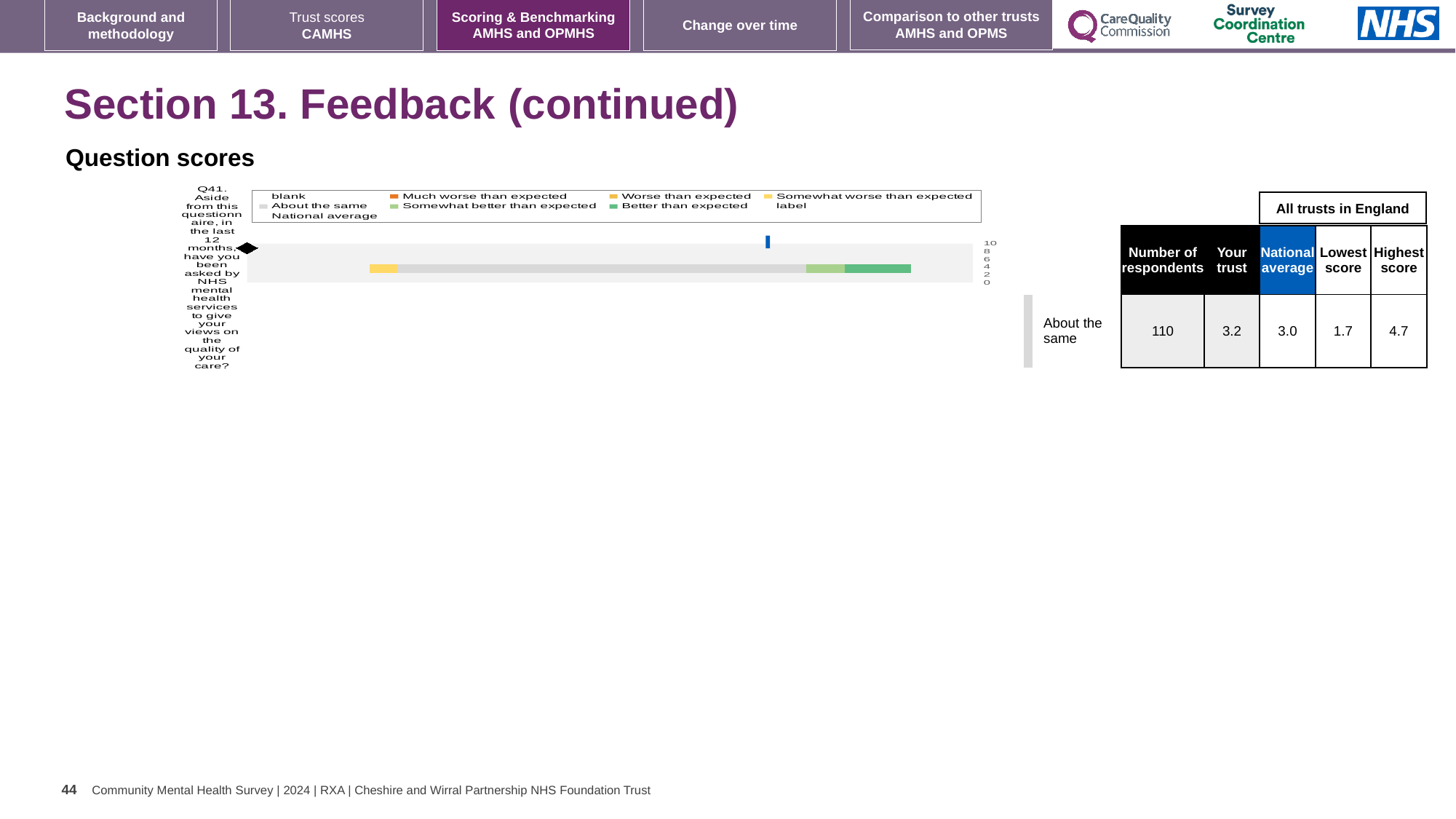
How many respondents answered Q41? 110 What kind of chart is used to show the Q41 question score? bar chart By how much does the 'Your trust' score exceed the national average for Q41? 0.2 What colour does the legend use for 'Better than expected'? green Which benchmark category is the trust's Q41 score placed in? About the same What is the difference between the highest score and the lowest score for Q41? 3.0 Which is larger for Q41, the 'Your trust' score or the national average? Your trust How many survey questions are plotted on the chart? 1 What is the highest score among all trusts in England for Q41? 4.7 What is the 'Your trust' score for Q41? 3.2 What is the lowest score among all trusts in England for Q41? 1.7 What is the national average score for Q41? 3.0